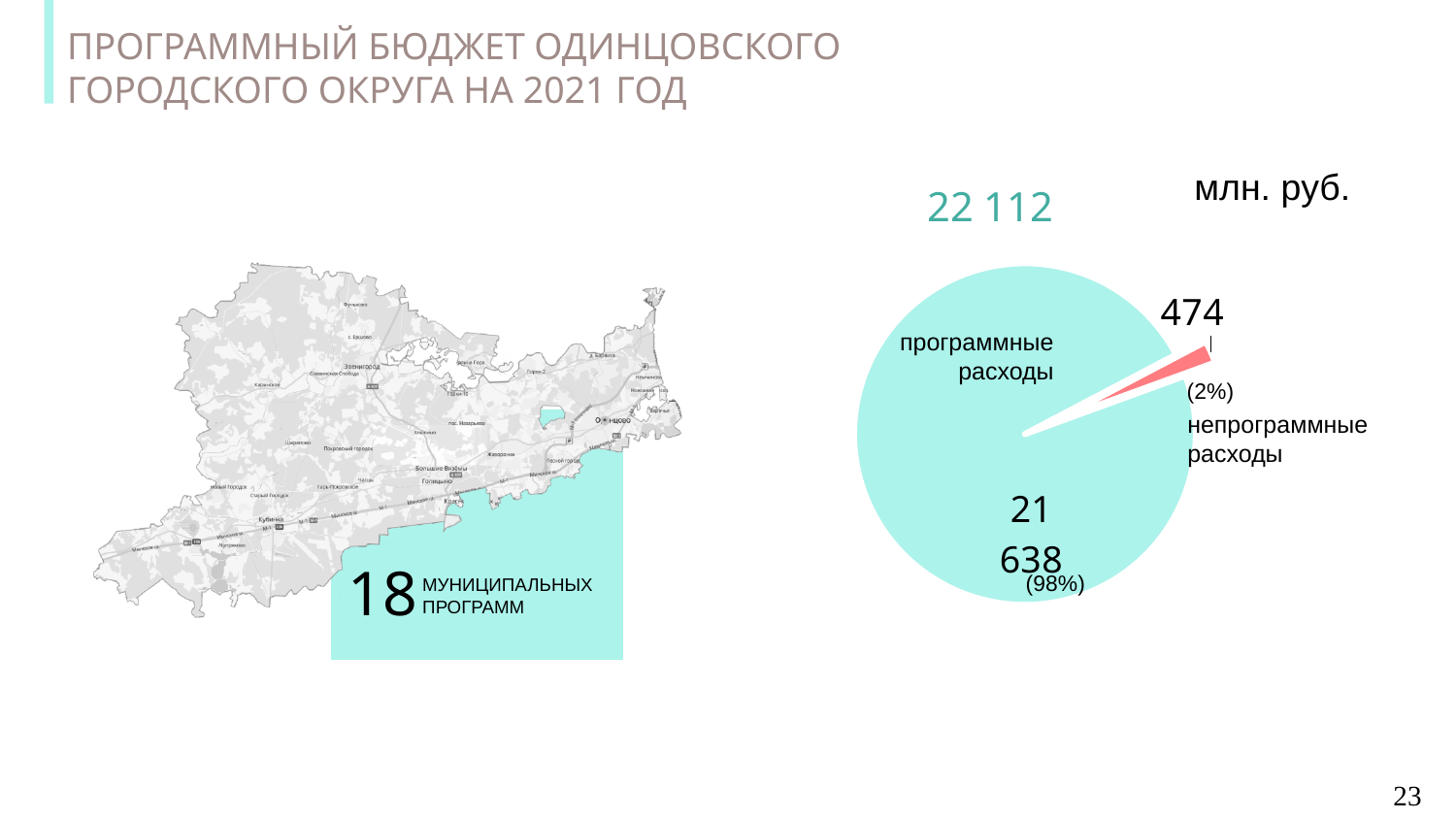
How many slices does the pie chart have? 2 What is the value for непрограммные расходы in the pie chart? 474 In what units are the values of the pie chart given? млн. руб. What share of the pie does непрограммные расходы take? 2% What share of the pie does программные расходы take? 98% Which slice of the pie chart is the largest? программные расходы What is the total value shown above the pie chart? 22 112 Which is larger, программные расходы or непрограммные расходы? программные расходы What kind of chart is shown on the slide? pie chart Which slice of the pie chart is the smallest? непрограммные расходы What is the value for программные расходы in the pie chart? 21 638 What is the difference between программные расходы and непрограммные расходы? 21 164